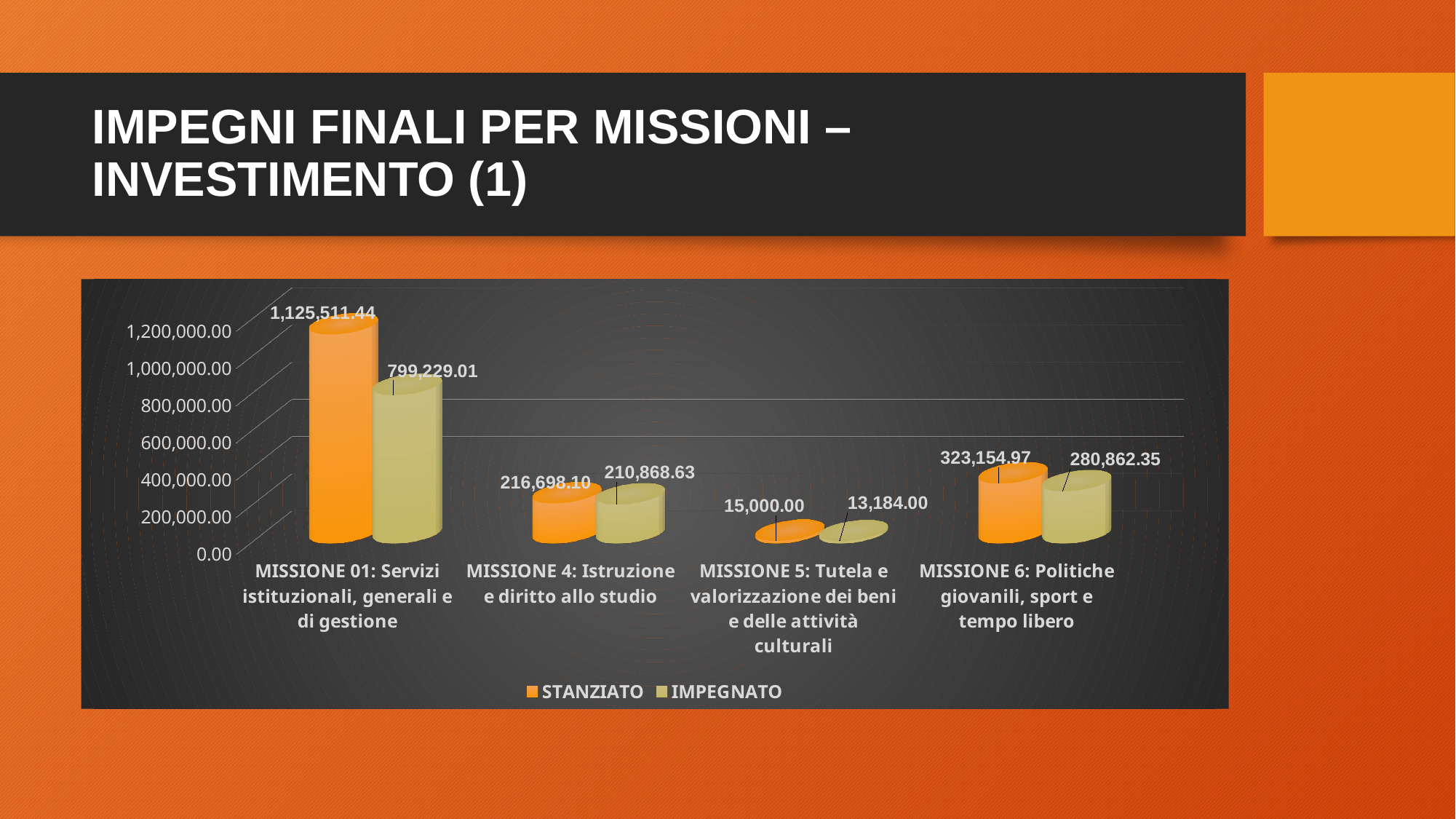
How many series does the legend list? 2 What is the IMPEGNATO value for MISSIONE 4: Istruzione e diritto allo studio? 210,868.63 Which is larger for MISSIONE 4: the STANZIATO value or the IMPEGNATO value? STANZIATO What kind of chart is shown on the slide? Bar chart What is the STANZIATO value for MISSIONE 5: Tutela e valorizzazione dei beni e delle attività culturali? 15,000.00 What is the difference between the STANZIATO and IMPEGNATO values for MISSIONE 01? 326,282.43 What is the STANZIATO value for MISSIONE 01: Servizi istituzionali, generali e di gestione? 1,125,511.44 How many missions (categories) are shown on the x axis? 4 Which mission has the lowest IMPEGNATO value? MISSIONE 5: Tutela e valorizzazione dei beni e delle attività culturali What is the difference between the STANZIATO and IMPEGNATO values for MISSIONE 6? 42,292.62 Which mission has the highest STANZIATO value? MISSIONE 01: Servizi istituzionali, generali e di gestione What is the IMPEGNATO value for MISSIONE 6: Politiche giovanili, sport e tempo libero? 280,862.35